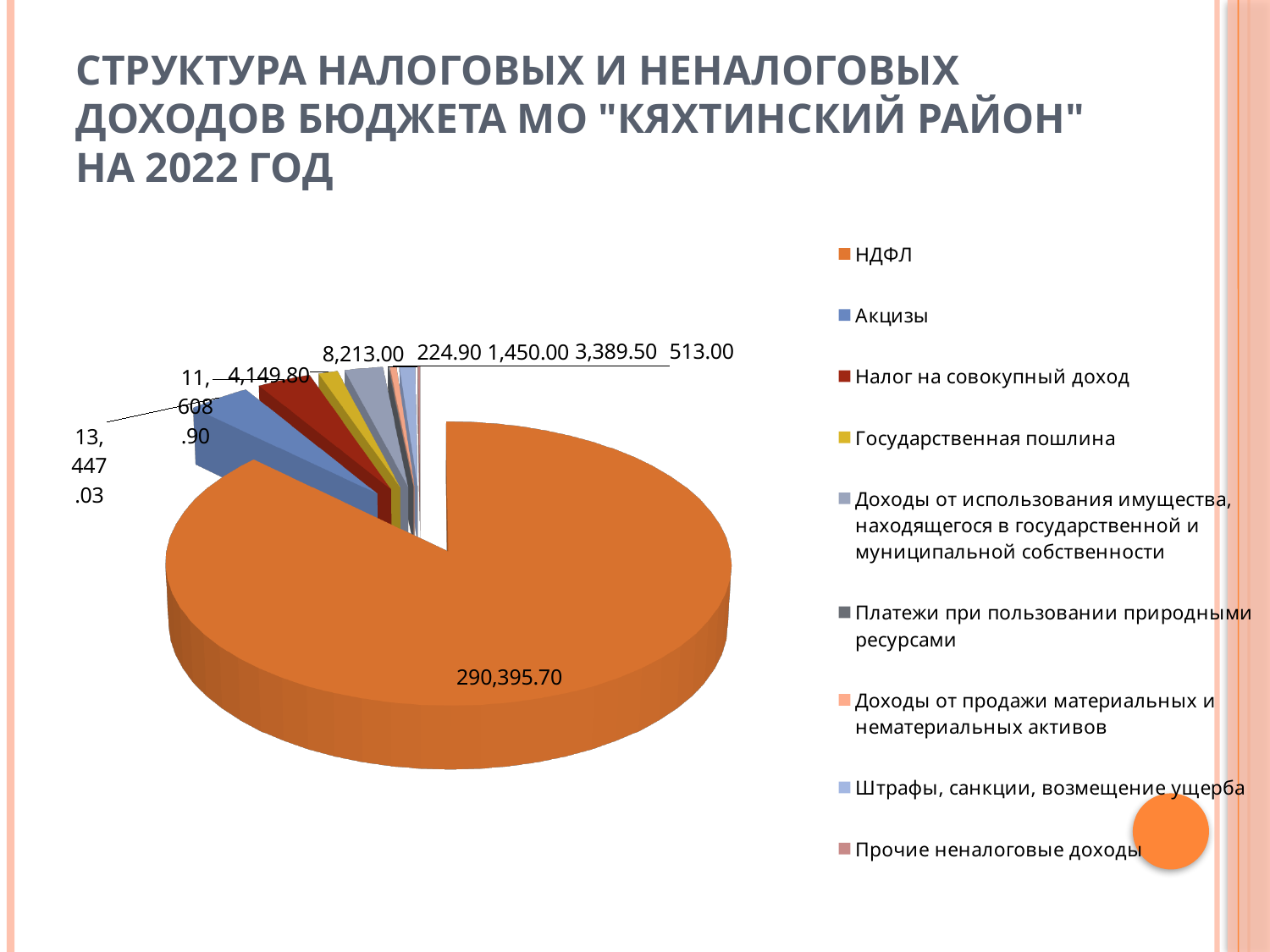
What is the difference between the values for Доходы от продажи материальных и нематериальных активов (1,450.00) and Платежи при пользовании природными ресурсами (224.90)? 1,225.10 What is the value shown for Прочие неналоговые доходы? 513.00 What is the value shown for Штрафы, санкции, возмещение ущерба? 3,389.50 How many categories does the legend of the pie chart list? 9 Which is larger: the value for Государственная пошлина or the value for Штрафы, санкции, возмещение ущерба? Государственная пошлина Which category has the largest slice of the pie? НДФЛ What is the value shown for Доходы от использования имущества, находящегося в государственной и муниципальной собственности? 8,213.00 What kind of chart is shown on the slide? Pie chart What colour is used for НДФЛ in the pie chart? Orange Which category has the smallest value in the pie chart? Платежи при пользовании природными ресурсами What is the value shown for НДФЛ? 290,395.70 What is the value shown for Платежи при пользовании природными ресурсами? 224.90